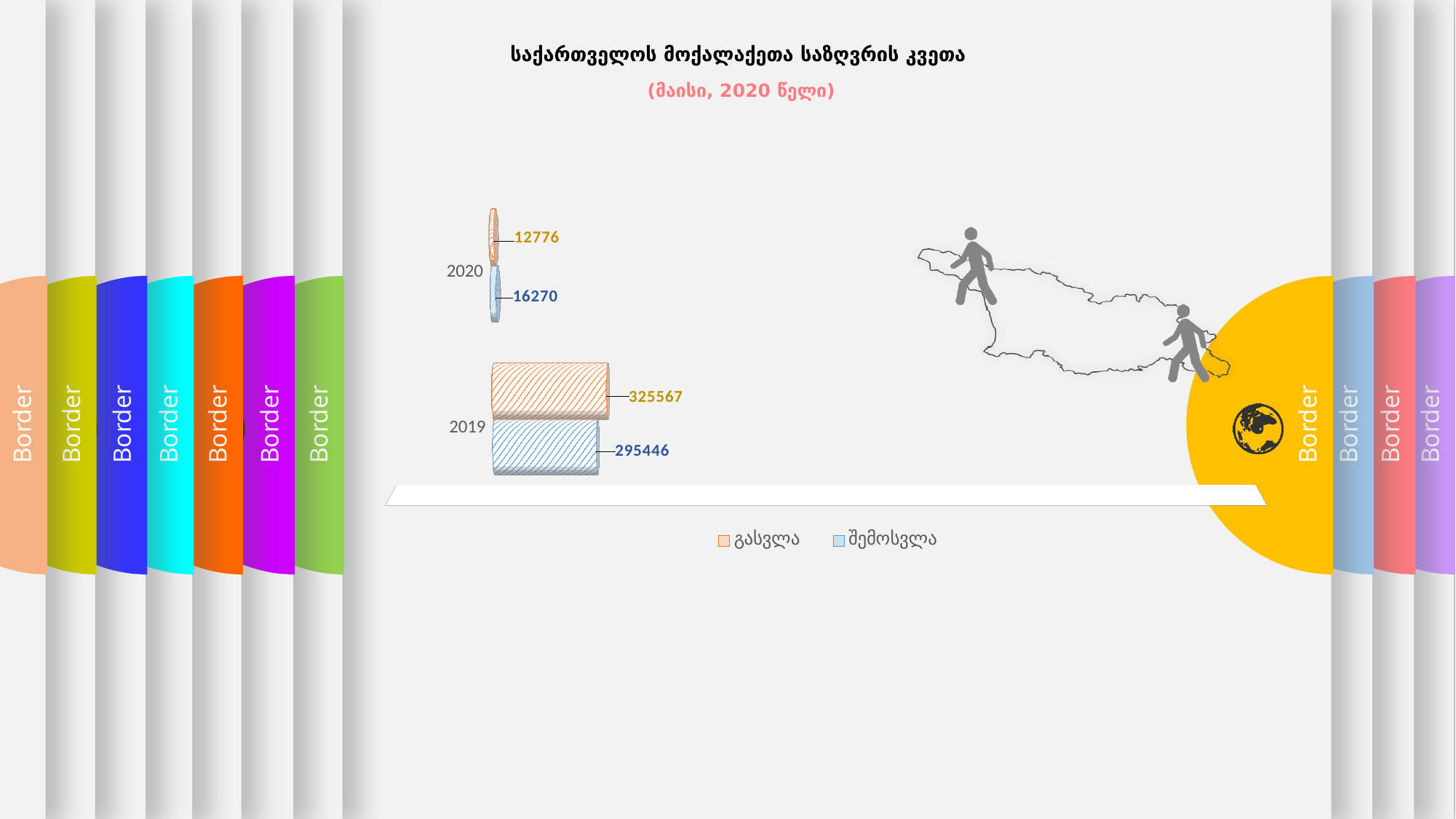
What kind of chart is shown on the slide? Bar chart Which year has the higher value for გასვლა? 2019 What is the value for გასვლა in 2019? 325567 What is the difference between გასვლა and შემოსვლა in 2019? 30121 How many series does the legend list? 2 What is the value for შემოსვლა in 2019? 295446 Which year has the lowest value for შემოსვლა? 2020 In 2020, which is larger: გასვლა or შემოსვლა? შემოსვლა How many years are shown on the chart? 2 What is the value for გასვლა in 2020? 12776 What is the difference between შემოსვლა and გასვლა in 2020? 3494 What is the value for შემოსვლა in 2020? 16270